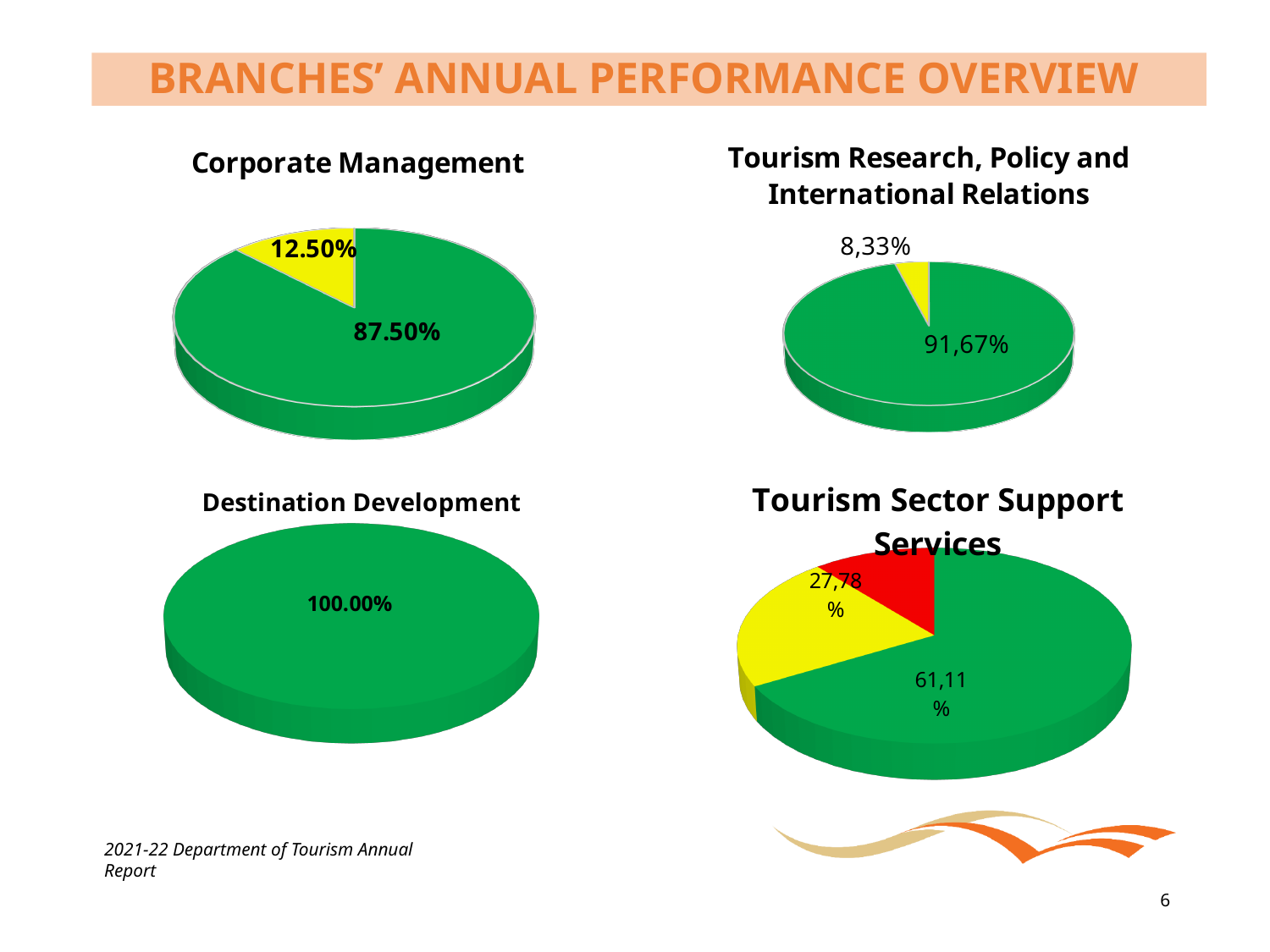
What kind of chart is the Corporate Management chart? Pie chart How many pie charts are shown on the slide? 4 In the Tourism Sector Support Services chart, what percentage is shown for the green slice? 61,11% In the Tourism Sector Support Services chart, what percentage is shown for the yellow slice? 27,78% In the Corporate Management chart, what percentage is shown for the yellow slice? 12.50% In the Corporate Management chart, what is the difference between the green slice and the yellow slice? 75.00% How many slices does the Tourism Sector Support Services chart have? 3 In the Tourism Sector Support Services chart, which slice is larger, the green one or the yellow one? The green one In the Tourism Research, Policy and International Relations chart, what percentage is shown for the green slice? 91,67% In the Corporate Management chart, what percentage is shown for the green slice? 87.50% In the Destination Development chart, what percentage is shown for the green slice? 100.00% In the Tourism Research, Policy and International Relations chart, what percentage is shown for the yellow slice? 8,33%